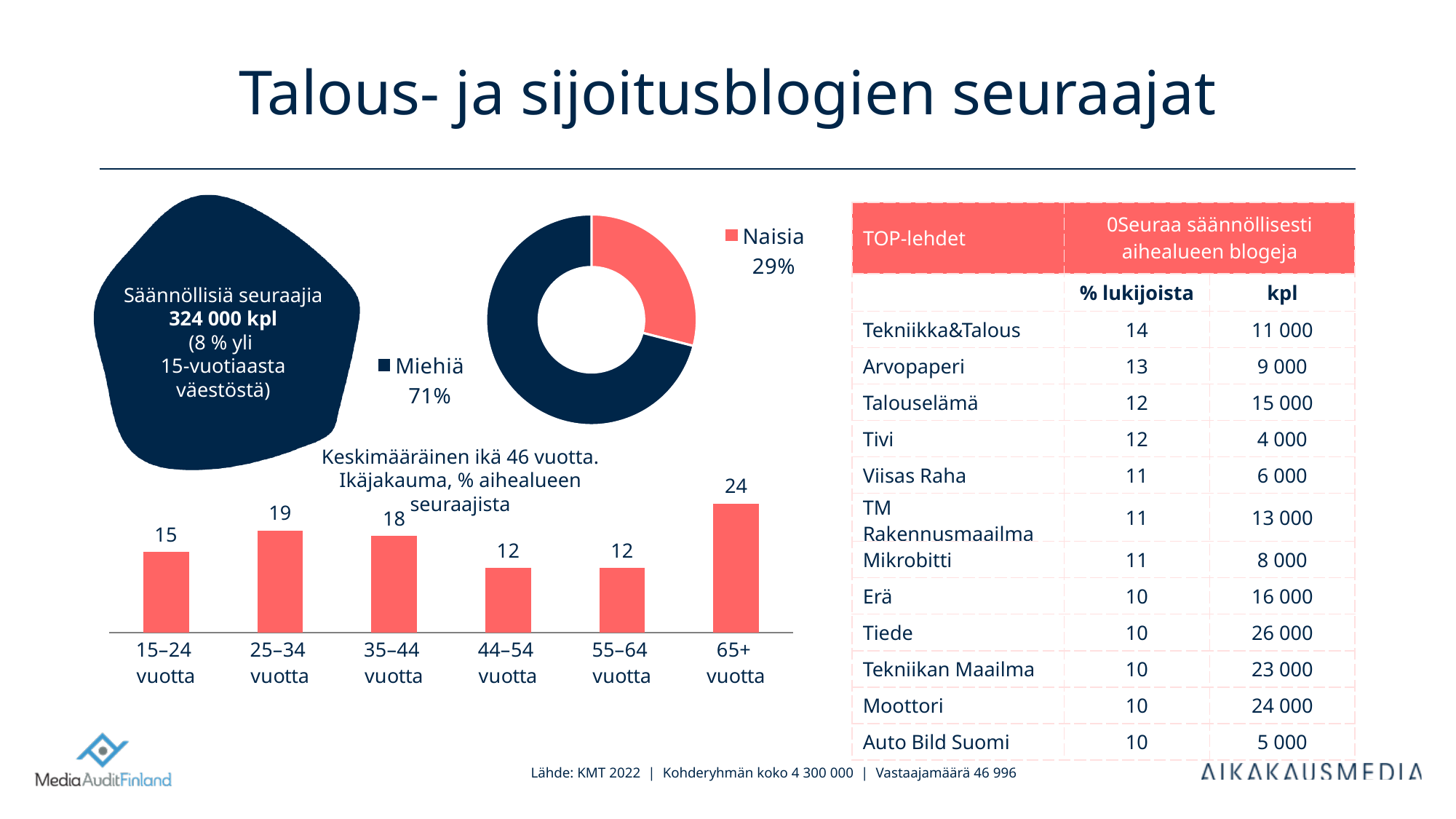
How many entries does the legend of the donut chart list? 2 What kind of chart shows the age distribution (Ikäjakauma)? Bar chart In the age distribution bar chart, what is the difference between the values for 65+ vuotta and 15–24 vuotta? 9 In the age distribution bar chart, what is the value for 65+ vuotta? 24 In the age distribution bar chart, what is the value for 25–34 vuotta? 19 In the donut chart, which group is larger, Naisia or Miehiä? Miehiä How many age groups are shown in the age distribution bar chart? 6 What kind of chart shows the Naisia and Miehiä shares? Donut chart In the age distribution bar chart, which is larger, the value for 35–44 vuotta or 44–54 vuotta? 35–44 vuotta In the donut chart, what share of followers are Naisia? 29% In the age distribution bar chart, which age group has the highest value? 65+ vuotta In the donut chart, what share of followers are Miehiä? 71%